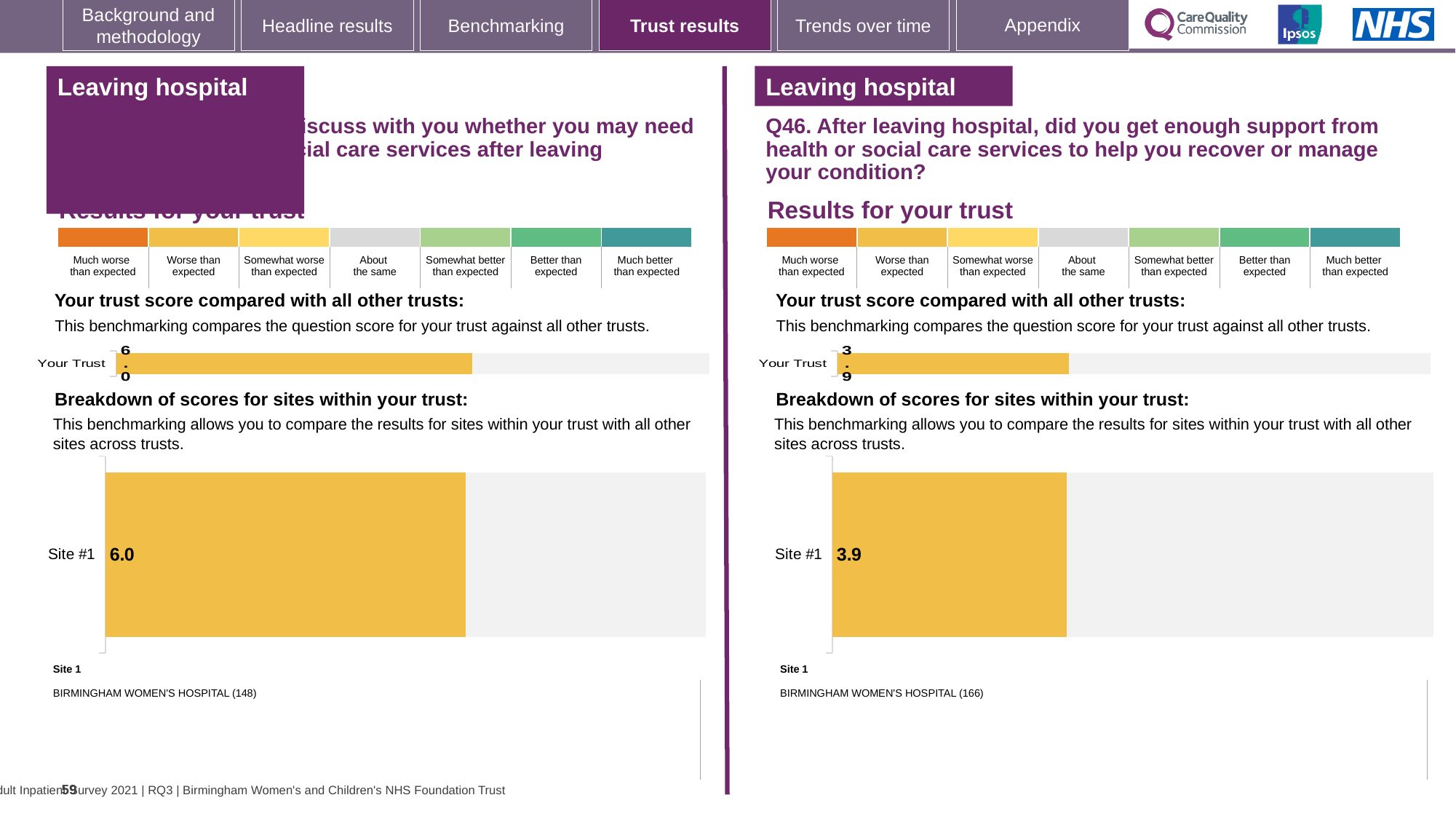
On the right-hand (Q46) 'Breakdown of scores for sites within your trust' chart, what is the value for Site #1? 3.9 On the right-hand (Q46) site breakdown chart, what colour is the bar for Site #1? Yellow/orange On the right-hand (Q46) site breakdown chart, which hospital is listed as Site 1? BIRMINGHAM WOMEN'S HOSPITAL (166) Which is larger: the Your Trust score on the left-hand chart or the Your Trust score on the right-hand (Q46) chart? The left-hand chart (6.0) What kind of chart is the left-hand 'Your trust score compared with all other trusts' chart? Bar chart What is the difference between the Site #1 score on the left-hand site breakdown chart and the Site #1 score on the right-hand (Q46) site breakdown chart? 2.1 What kind of chart is the right-hand (Q46) 'Breakdown of scores for sites within your trust' chart? Bar chart On the left-hand 'Breakdown of scores for sites within your trust' chart, what is the value for Site #1? 6.0 On the right-hand (Q46) 'Your trust score compared with all other trusts' chart, what is the value for Your Trust? 3.9 How many sites are shown on the left-hand 'Breakdown of scores for sites within your trust' chart? 1 On the left-hand 'Your trust score compared with all other trusts' chart, what is the value for Your Trust? 6.0 How many sites are shown on the right-hand (Q46) 'Breakdown of scores for sites within your trust' chart? 1